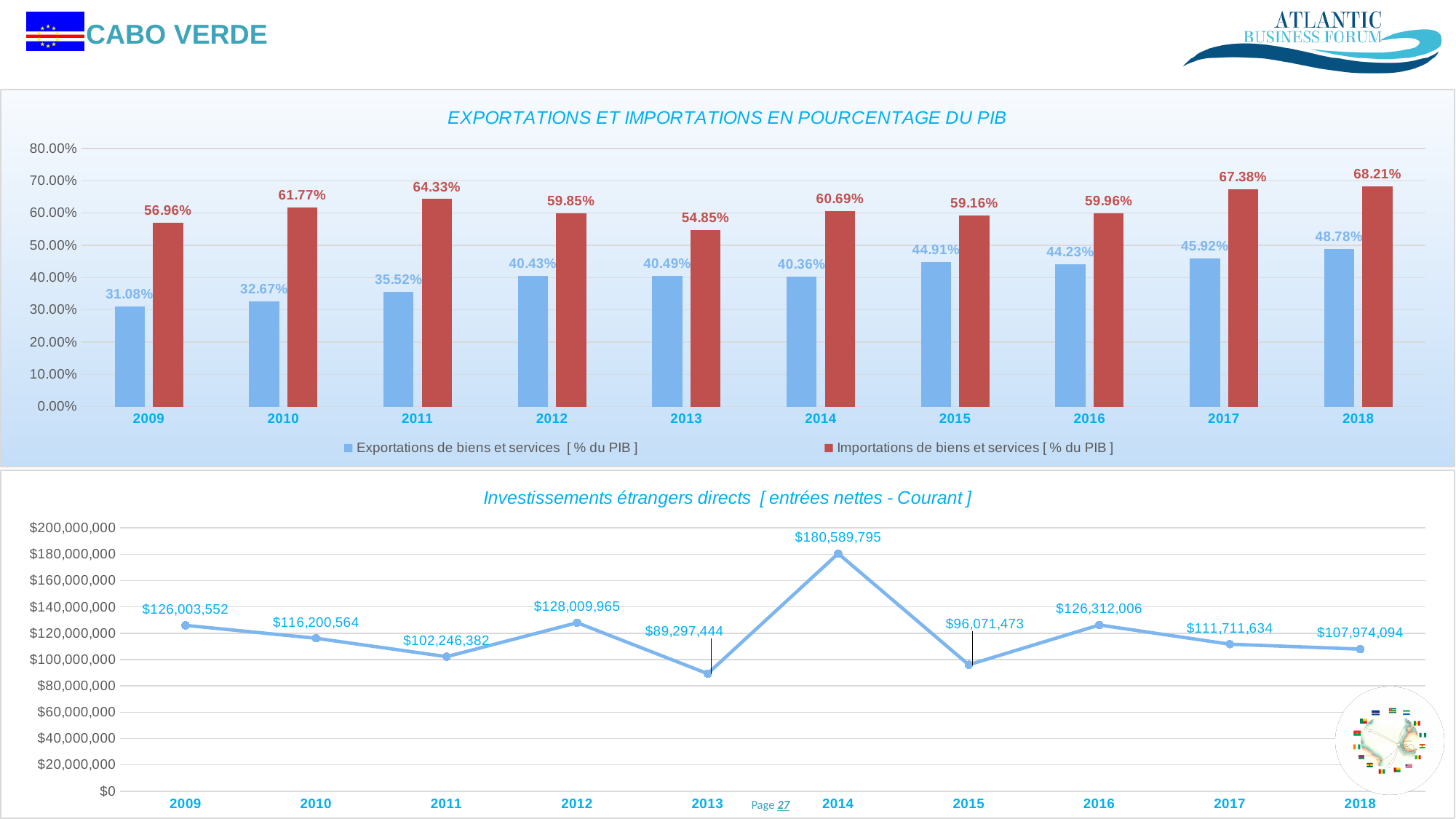
In the chart 'Investissements étrangers directs [entrées nettes - Courant]', which year has the lowest value? 2013 In the chart 'EXPORTATIONS ET IMPORTATIONS EN POURCENTAGE DU PIB', which year has the lowest value for Exportations de biens et services? 2009 In the chart 'Investissements étrangers directs [entrées nettes - Courant]', is the value for 2016 larger than the value for 2017? Yes In the chart 'EXPORTATIONS ET IMPORTATIONS EN POURCENTAGE DU PIB', what is the value of Exportations de biens et services in 2012? 40.43% In the chart 'EXPORTATIONS ET IMPORTATIONS EN POURCENTAGE DU PIB', what kind of chart is shown? Bar chart In the chart 'EXPORTATIONS ET IMPORTATIONS EN POURCENTAGE DU PIB', how many series does the legend list? 2 In the chart 'EXPORTATIONS ET IMPORTATIONS EN POURCENTAGE DU PIB', what is the value of Importations de biens et services in 2011? 64.33% In the chart 'EXPORTATIONS ET IMPORTATIONS EN POURCENTAGE DU PIB', which year has the highest value for Importations de biens et services? 2018 In the chart 'EXPORTATIONS ET IMPORTATIONS EN POURCENTAGE DU PIB', what is the difference between Importations and Exportations in 2018? 19.43% In the chart 'Investissements étrangers directs [entrées nettes - Courant]', what is the difference between the 2014 and 2013 values? $91,292,351 In the chart 'Investissements étrangers directs [entrées nettes - Courant]', what is the value for 2014? $180,589,795 In the chart 'Investissements étrangers directs [entrées nettes - Courant]', how many years are plotted on the x axis? 10